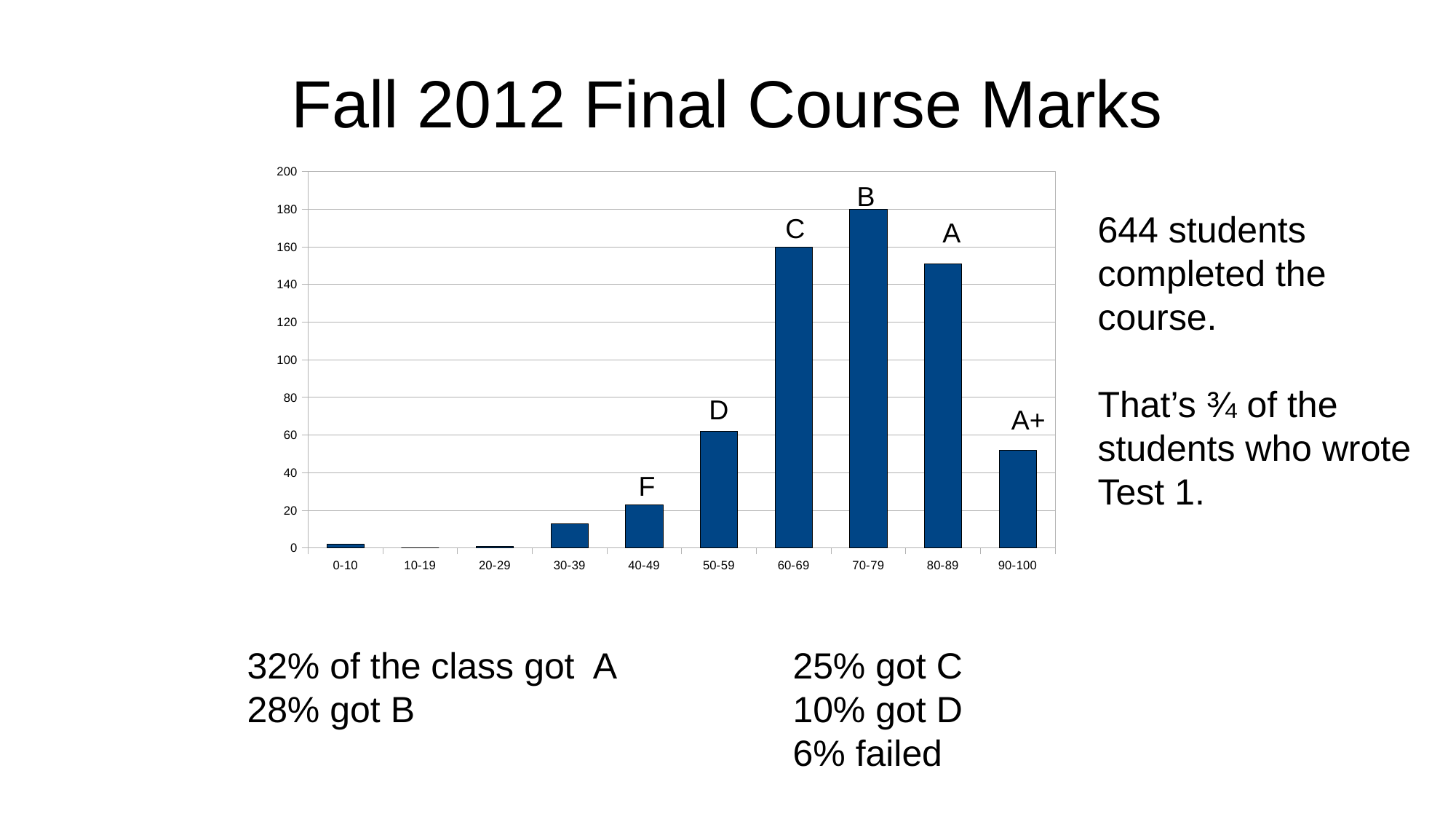
Is the value for the 80-89 range greater or less than 140? greater What kind of chart is shown on the slide? bar chart Which is larger, the bar for 50-59 or the bar for 90-100? 50-59 Which mark range has the highest bar? 70-79 Is the value for the 50-59 range greater or less than 80? less Do the bar values rise or fall from the 70-79 range to the 90-100 range? fall Is the value for the 90-100 range greater or less than 40? greater What is the value of the bar for the 70-79 range? 180 Which letter grade label is placed above the 70-79 bar? B How many mark ranges (categories) are shown on the x axis? 10 What is the value of the bar for the 60-69 range? 160 Which is larger, the bar for 60-69 or the bar for 80-89? 60-69